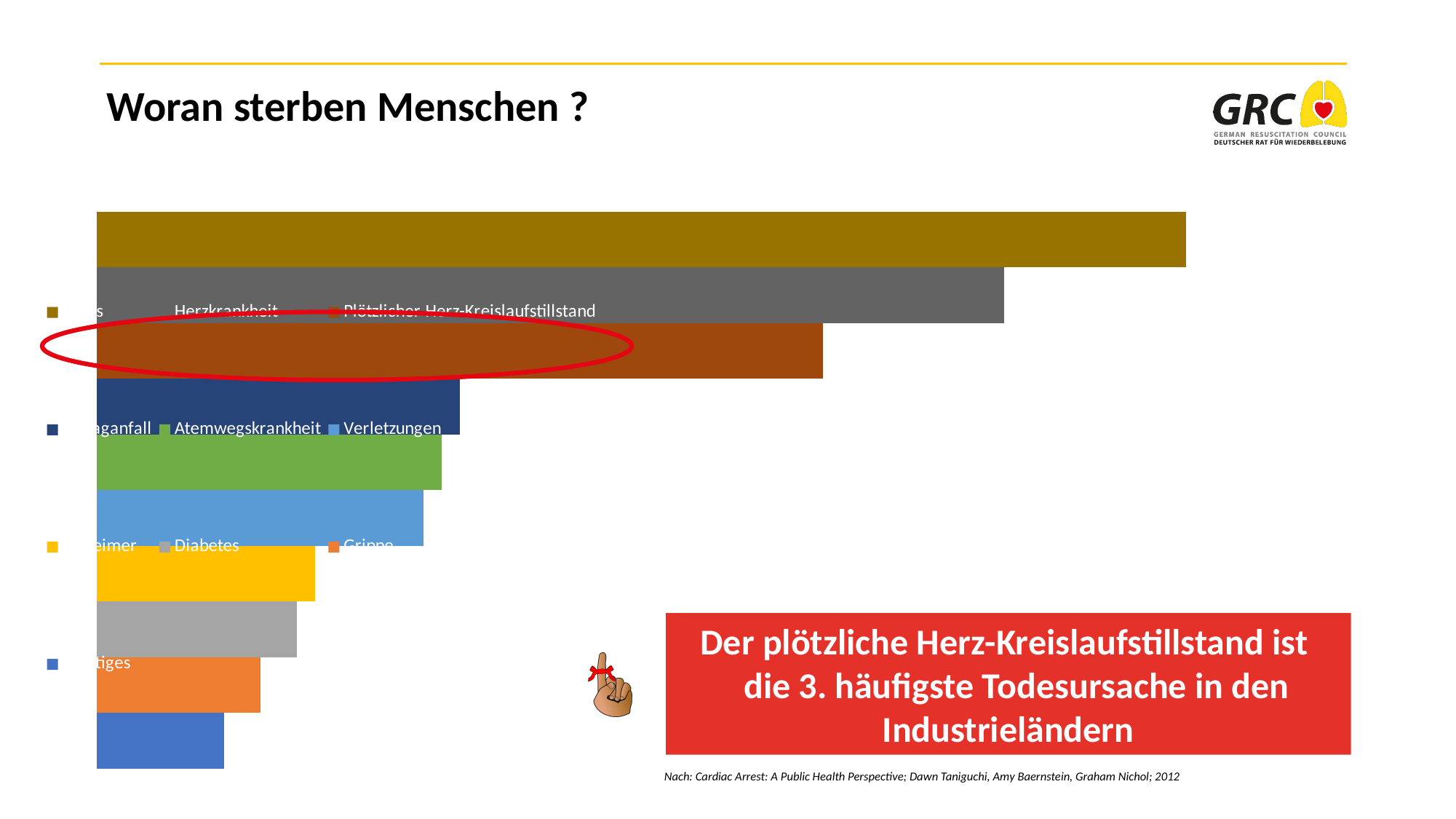
Which bar is longer: Diabetes or Verletzungen? Verletzungen Which bar is longer: Herzkrankheit or Plötzlicher Herz-Kreislaufstillstand? Herzkrankheit Do the bars get longer or shorter going from the top of the chart to the bottom? shorter What kind of chart is shown on the slide? bar chart Are the bars in the chart drawn horizontally or vertically? horizontally Which category's bar is circled in red on the chart? Plötzlicher Herz-Kreislaufstillstand In which position, ranked by bar length from longest to shortest, is Plötzlicher Herz-Kreislaufstillstand? third How many bars does the chart contain? 10